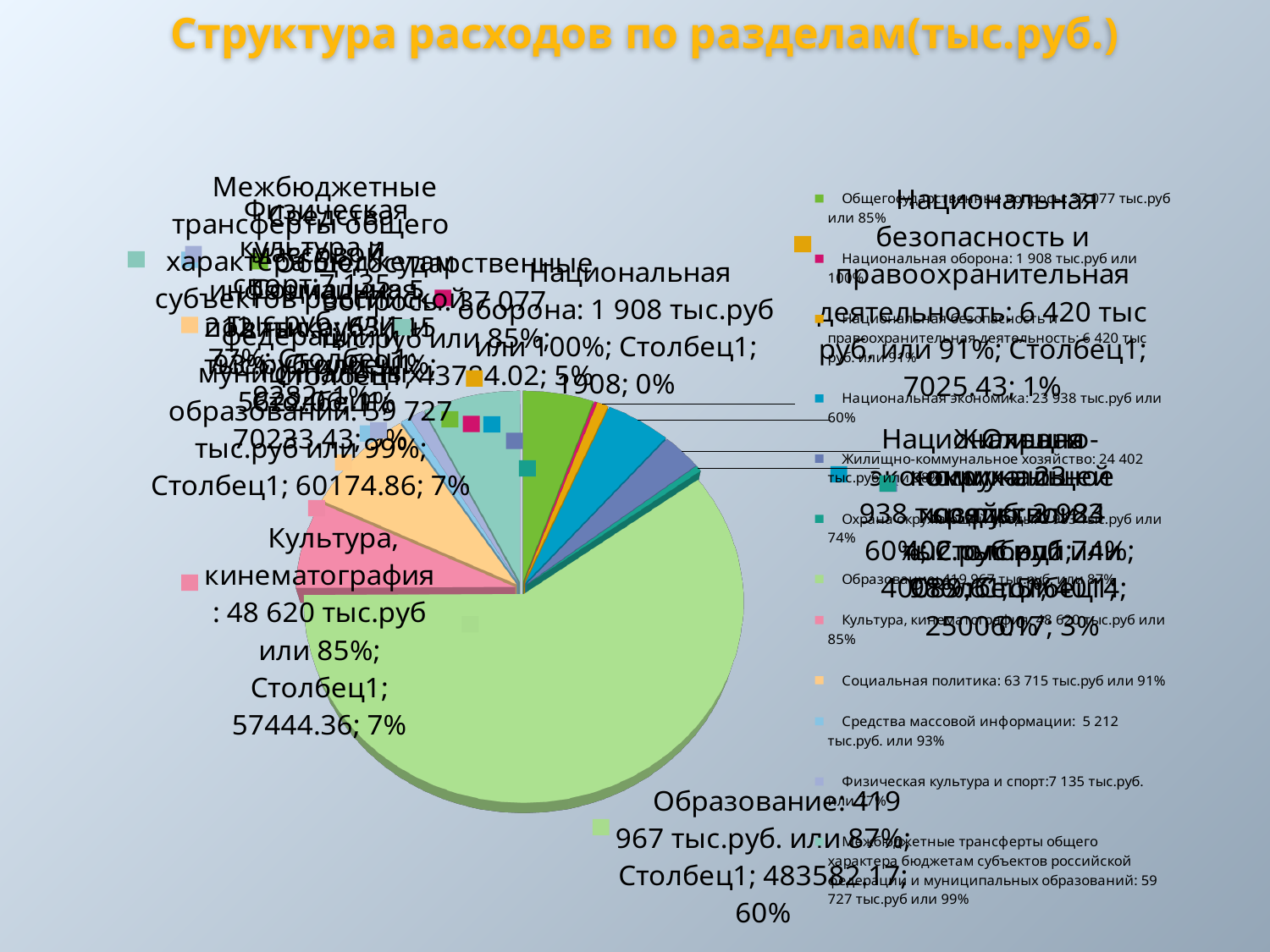
What value is shown for Культура, кинематография in the data label (Столбец1)? 57444.36 What share of the pie does the Культура, кинематография slice represent? 7% Which slice is larger: Образование or Культура, кинематография? Образование How many categories does the chart's legend list? 12 According to the legend, what amount is listed for Социальная политика? 63 715 тыс.руб или 91% Which category has the largest slice of the pie? Образование What share of the pie does the Образование slice represent? 60% What value is shown for Образование in the data label (Столбец1)? 483582.17 What is the title of the chart? Структура расходов по разделам(тыс.руб.) What share of the pie does the Межбюджетные трансферты общего характера slice represent? 7% What kind of chart is shown on the slide? pie chart What value is shown for Национальная оборона in the data label (Столбец1)? 1908